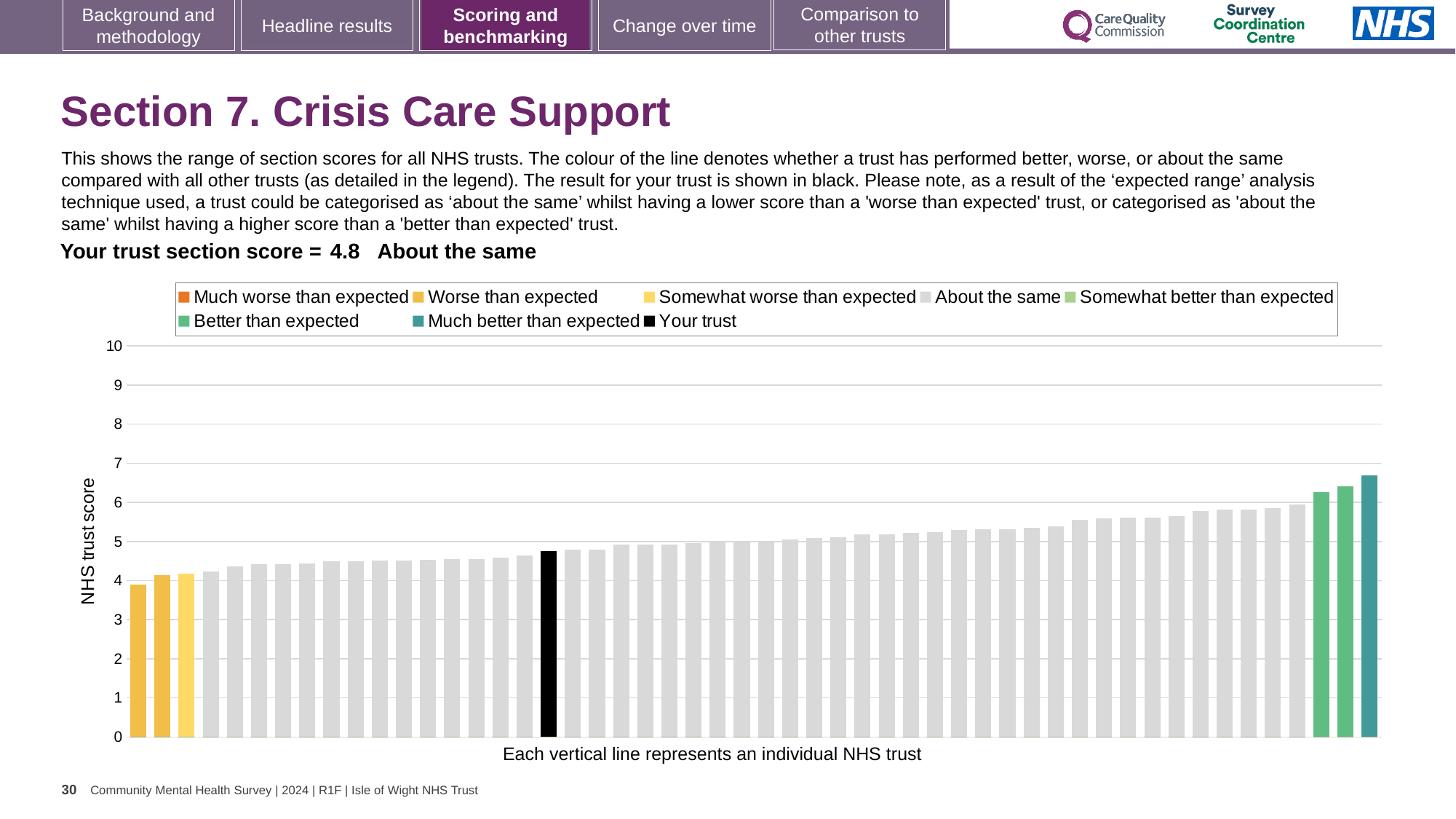
Is the value of the black bar (your trust) greater or less than 4? greater What is the label on the vertical axis of the chart? NHS trust score Is the value of the black bar (your trust) greater or less than 5? less What kind of chart is shown on the slide? Bar chart Is the value of the tallest bar greater or less than 6? greater Do the bar values rise or fall from left to right across the chart? Rise How is your trust's section score categorised compared with other trusts? About the same How many entries does the chart legend list? 8 What is the section score for your trust shown on the slide? 4.8 What colour is the bar representing your trust? Black